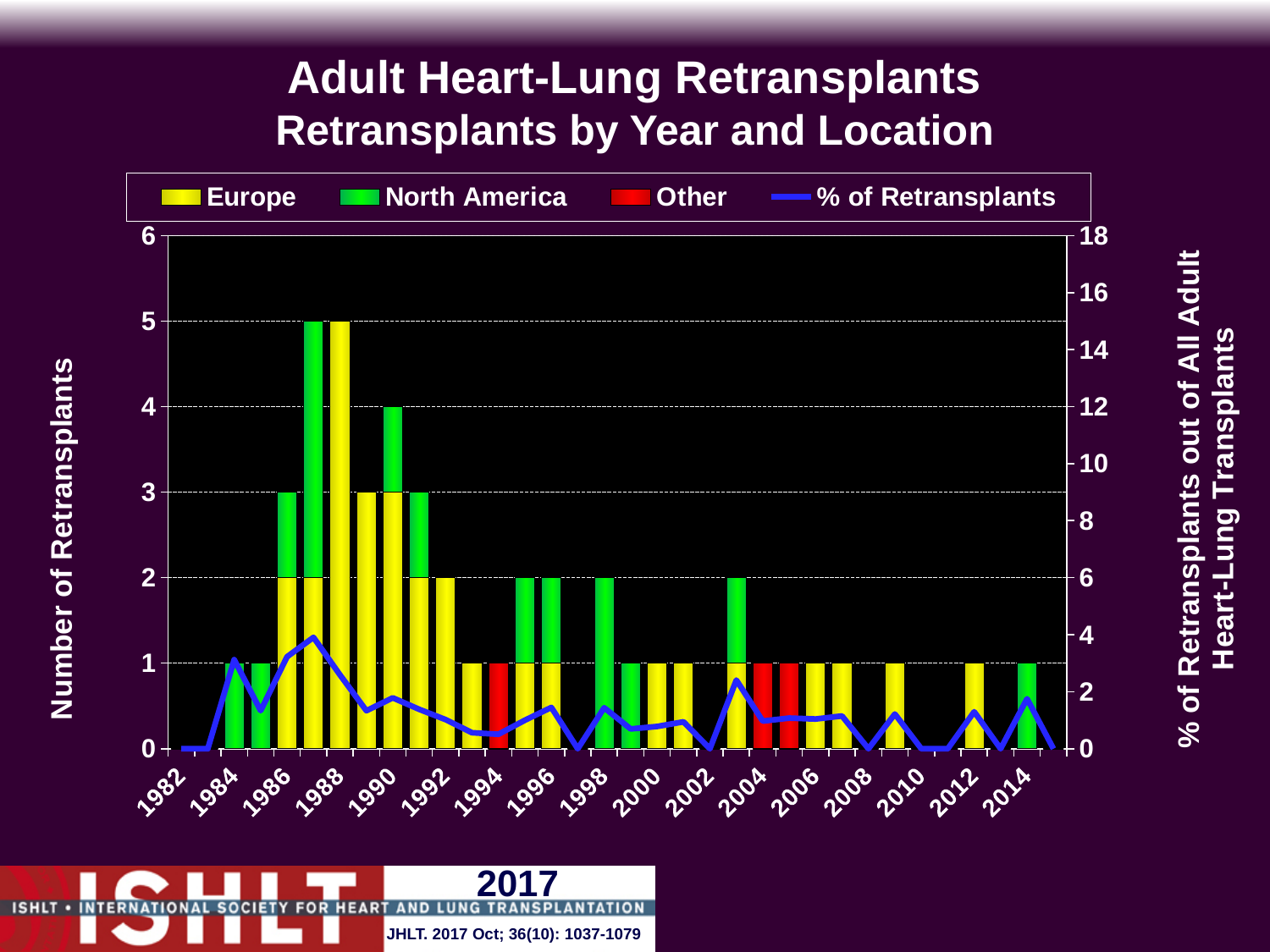
Which year has more total retransplants, 1988 or 1992? 1988 Which region accounts for the retransplant in 1994? Other Is the % of Retransplants value in 1986 greater or less than 2? greater How many retransplants were performed in Europe in 1988? 5 How many series does the legend list? 4 What is the difference between the total retransplants in 1988 and in 1990? 1 Do the total retransplant counts generally rise or fall from 1988 to 2014? fall What colour represents Europe in the chart? yellow How many retransplants were performed in North America in 1998? 2 What is the total number of retransplants in 1988? 5 What is the total number of retransplants in 1990? 4 What kind of chart is shown on the slide? combination bar and line chart